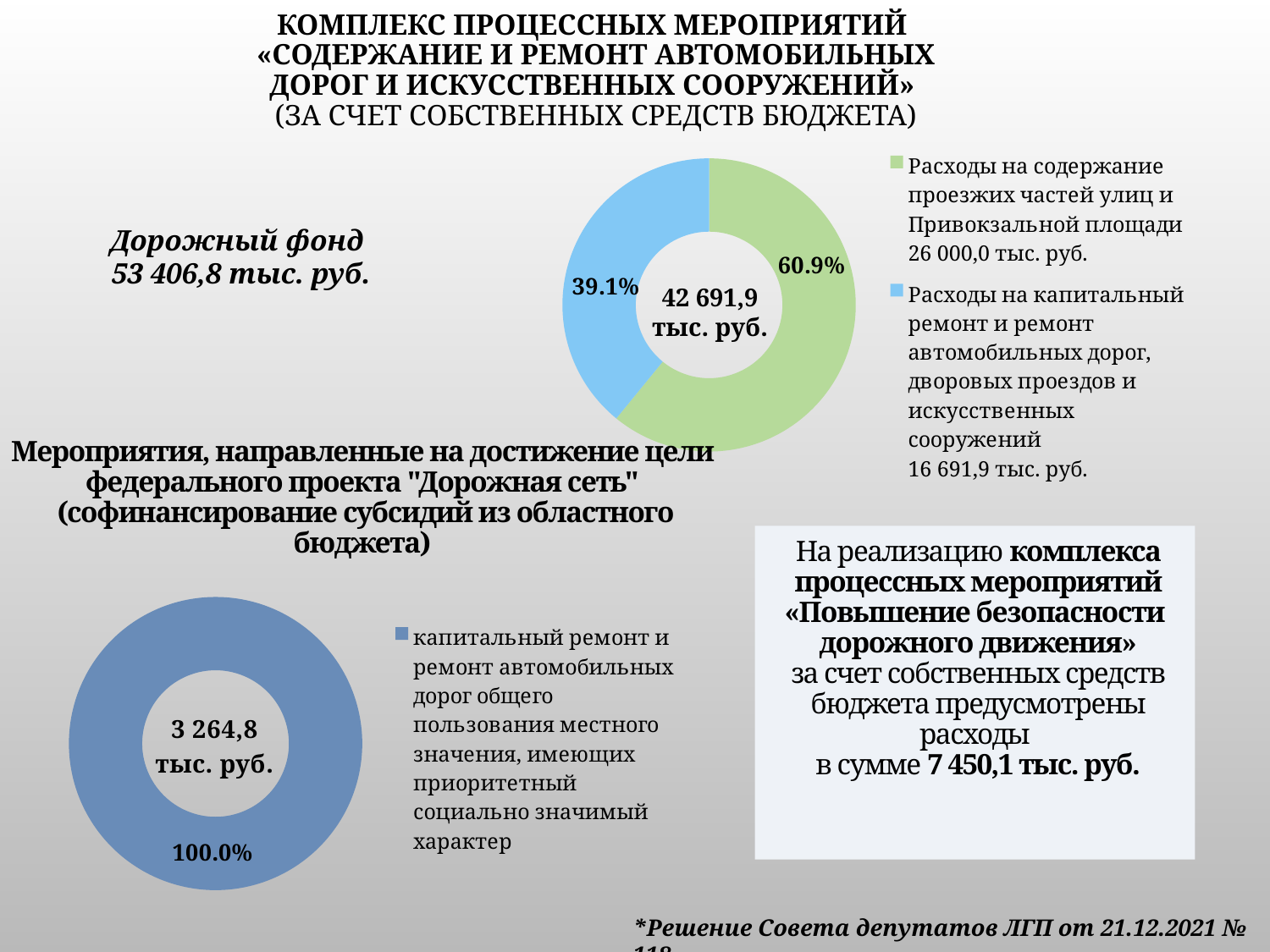
What kind of chart is the top chart on the slide? Donut (pie) chart What value is printed in the centre of the bottom-left donut chart? 3 264,8 тыс. руб. In the top donut chart, what is the difference in percentage points between the two slices? 21.8 According to the legend of the top donut chart, what amount is given for Расходы на капитальный ремонт и ремонт автомобильных дорог, дворовых проездов и искусственных сооружений? 16 691,9 тыс. руб. What total value is printed in the centre of the top donut chart? 42 691,9 тыс. руб. What share is shown for the single slice in the bottom-left donut chart? 100.0% How many categories does the legend of the top donut chart list? 2 In the top donut chart, which category has the larger share? Расходы на содержание проезжих частей улиц и Привокзальной площади According to the legend of the top donut chart, what amount is given for Расходы на содержание проезжих частей улиц и Привокзальной площади? 26 000,0 тыс. руб. In the top donut chart, what share is shown for the green slice (Расходы на содержание проезжих частей улиц и Привокзальной площади)? 60.9% In the top donut chart, what share is shown for the blue slice (Расходы на капитальный ремонт и ремонт автомобильных дорог, дворовых проездов и искусственных сооружений)? 39.1% In the top donut chart, which category has the smaller share? Расходы на капитальный ремонт и ремонт автомобильных дорог, дворовых проездов и искусственных сооружений